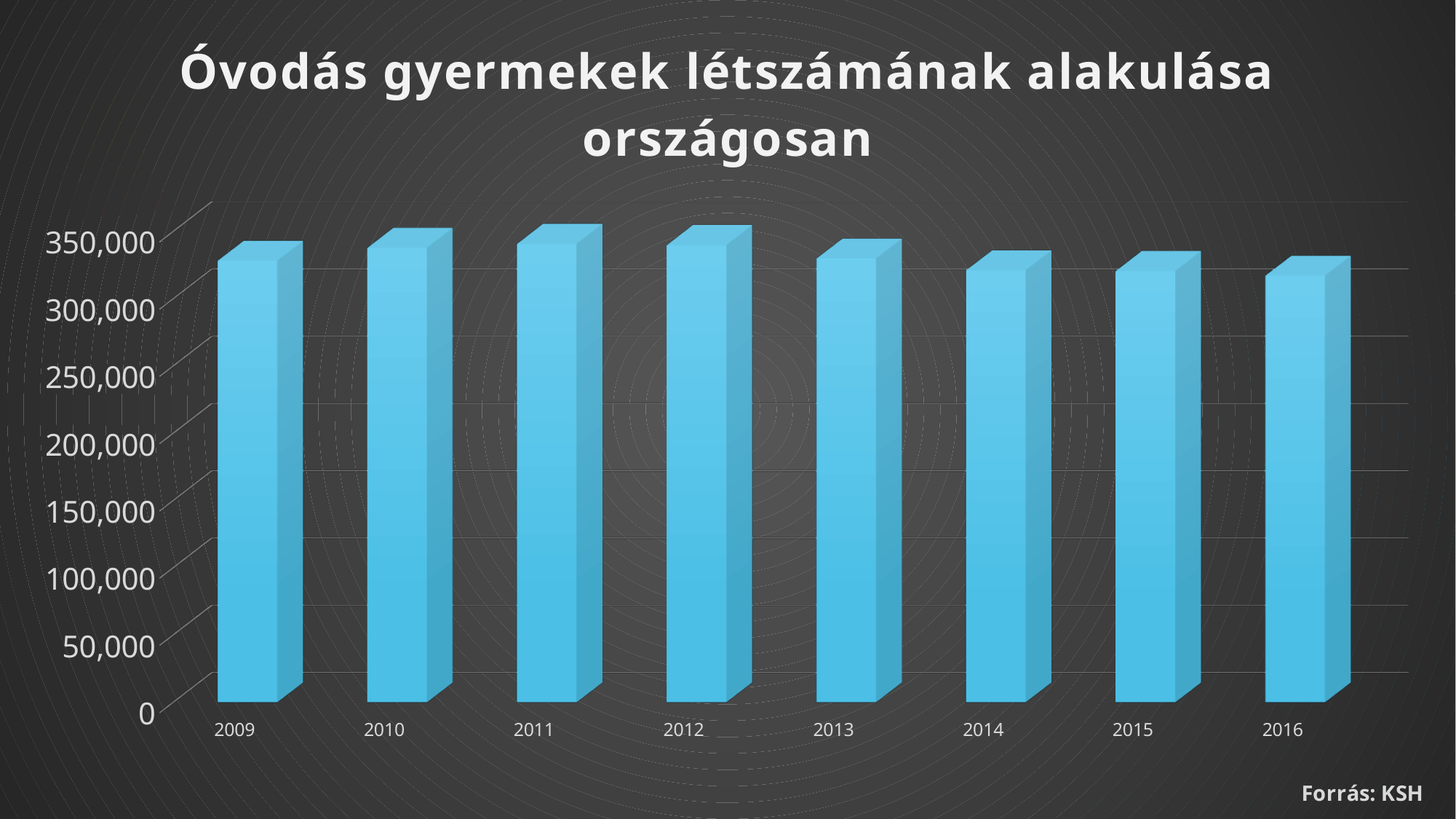
From 2012 to 2016, do the values rise or fall? fall From 2009 to 2011, do the values rise or fall? rise Is the value for 2011 greater or less than 350,000? less What kind of chart is shown on the slide? bar chart Is the value for 2016 greater or less than 300,000? greater Is the value for 2014 greater or less than 350,000? less What is the title of the chart? Óvodás gyermekek létszámának alakulása országosan How many years are shown on the x axis of the chart? 8 Which is larger, the value for 2011 or the value for 2016? 2011 Which is larger, the value for 2010 or the value for 2015? 2010 What source is cited for the chart data? KSH